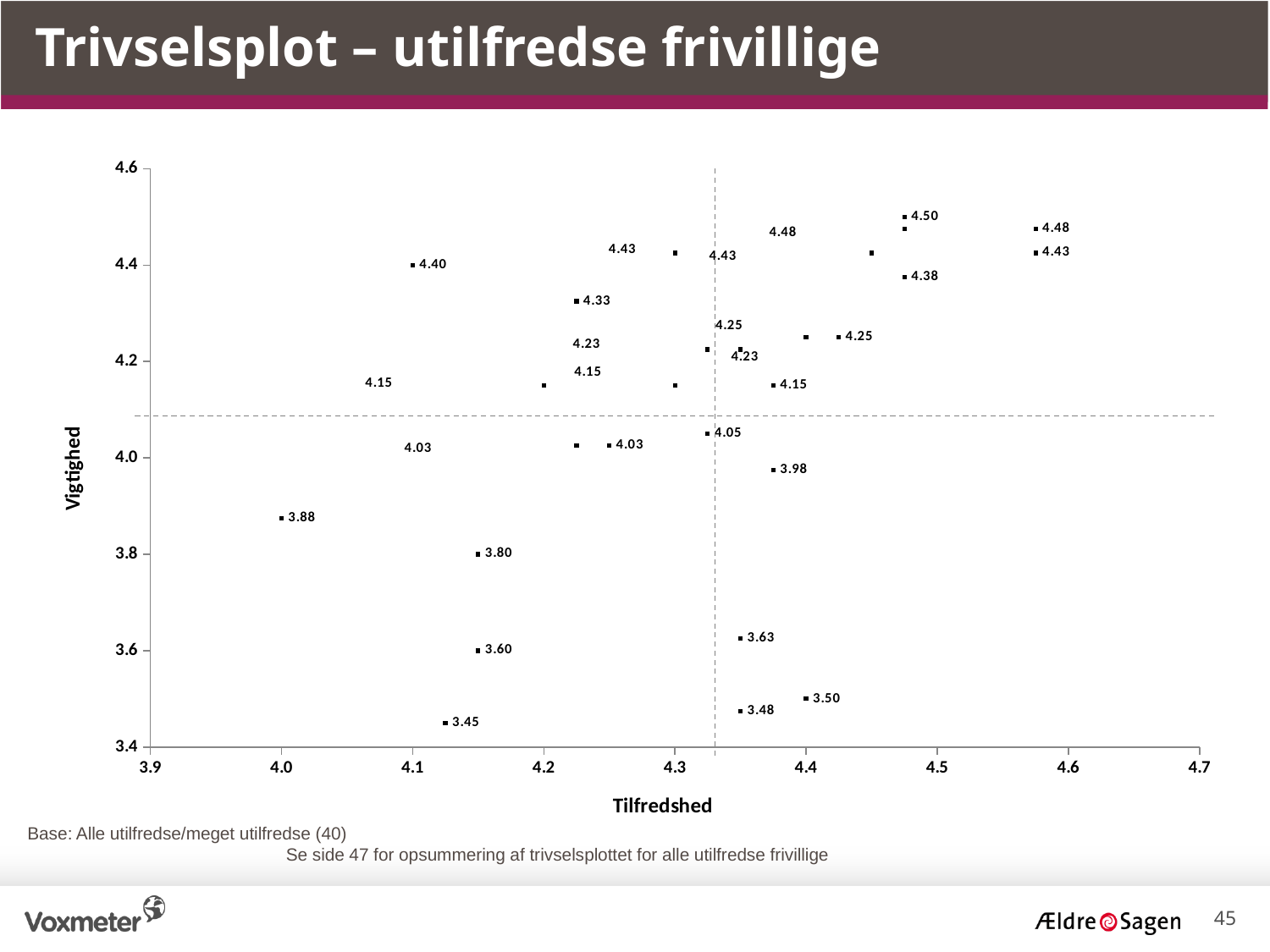
Which labelled value is larger, 3.63 or 3.60? 3.63 What is the maximum value shown on the vertical axis? 4.6 What is the highest Vigtighed value labelled on the chart? 4.50 Is the Tilfredshed value of the point labelled 3.45 greater or less than 4.2? less What is the difference between the highest labelled value (4.50) and the lowest labelled value (3.45)? 1.05 Is the Tilfredshed value of the point labelled 3.88 greater or less than 4.1? less What is the lowest Vigtighed value labelled on the chart? 3.45 What kind of chart is shown on the slide? scatter plot Is the Tilfredshed value of the point labelled 4.50 greater or less than 4.4? greater What is the title of the horizontal axis? Tilfredshed How many points on the chart are labelled 4.43? 3 What is the title of the vertical axis? Vigtighed